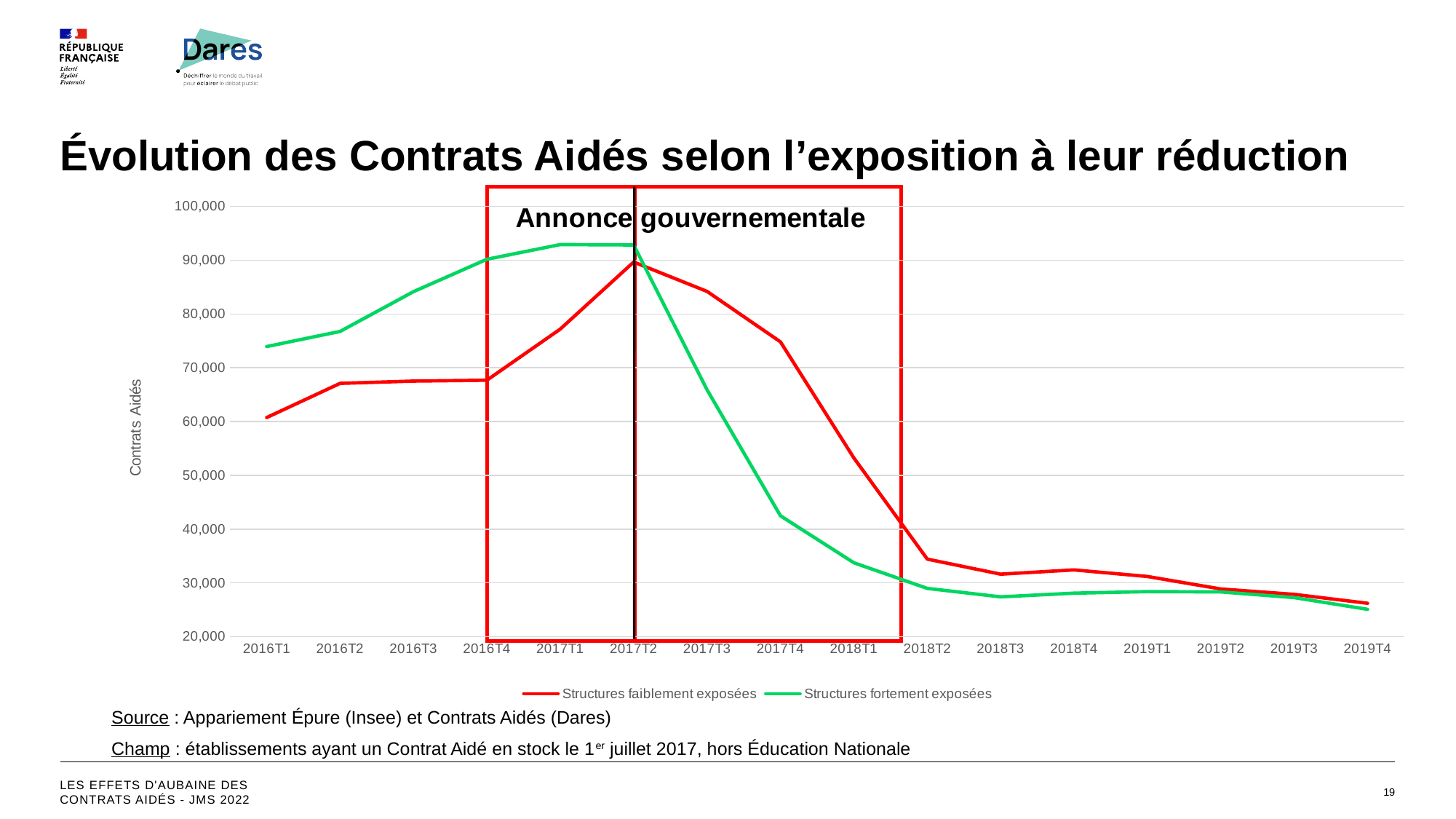
How many quarters are plotted along the x axis? 16 Does the series 'Structures fortement exposées' rise or fall between 2017T2 and 2018T3? fall What annotation is written inside the red box on the chart? Annonce gouvernementale In which quarter does the series 'Structures fortement exposées' reach its lowest value? 2019T4 Is the value for 'Structures fortement exposées' in 2017T4 greater or less than 50,000? less Is the value for 'Structures fortement exposées' in 2016T1 greater or less than 70,000? greater What kind of chart is shown on the slide? line chart How many series does the legend list? 2 In which quarter does the series 'Structures faiblement exposées' reach its highest value? 2017T2 Is the value for 'Structures faiblement exposées' in 2018T1 greater or less than 60,000? less In 2016T1, which series has the larger value, 'Structures faiblement exposées' or 'Structures fortement exposées'? Structures fortement exposées In 2018T1, which series has the larger value, 'Structures faiblement exposées' or 'Structures fortement exposées'? Structures faiblement exposées